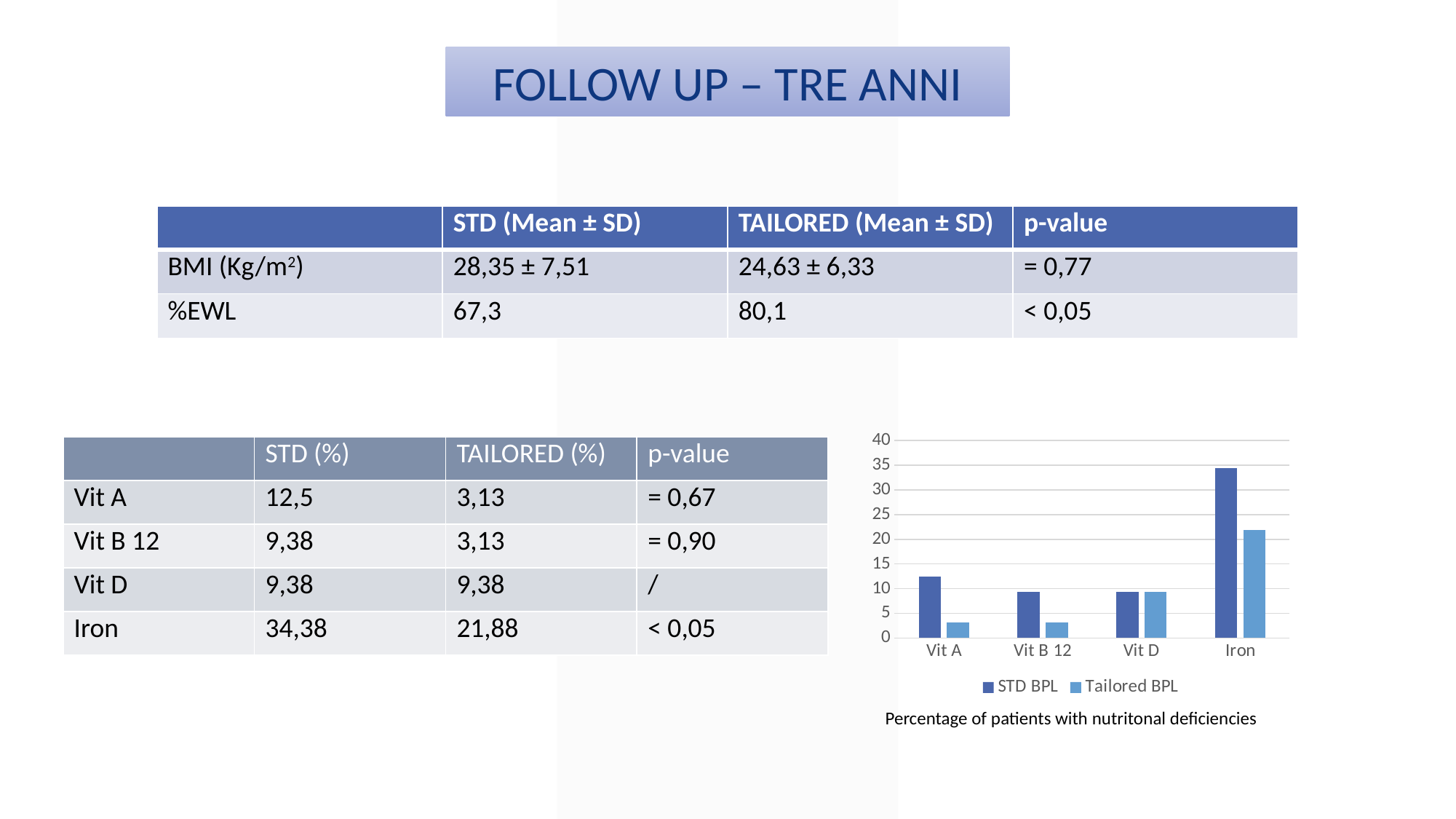
In the bar chart, which is larger for Iron: the STD BPL value or the Tailored BPL value? STD BPL How many categories are shown on the x axis of the bar chart? 4 Which category has the highest Tailored BPL value in the bar chart? Iron In the bar chart, is the Tailored BPL value for Iron greater or less than 20? greater In the bar chart, is the STD BPL value for Vit A greater or less than 10? greater How many series does the legend of the bar chart list? 2 In the bar chart, is the Tailored BPL value for Vit A greater or less than 5? less What caption is printed below the bar chart? Percentage of patients with nutritonal deficiencies In the bar chart, which is larger for Vit A: the STD BPL value or the Tailored BPL value? STD BPL What kind of chart is shown on the right of the slide? bar chart Which category has the highest STD BPL value in the bar chart? Iron